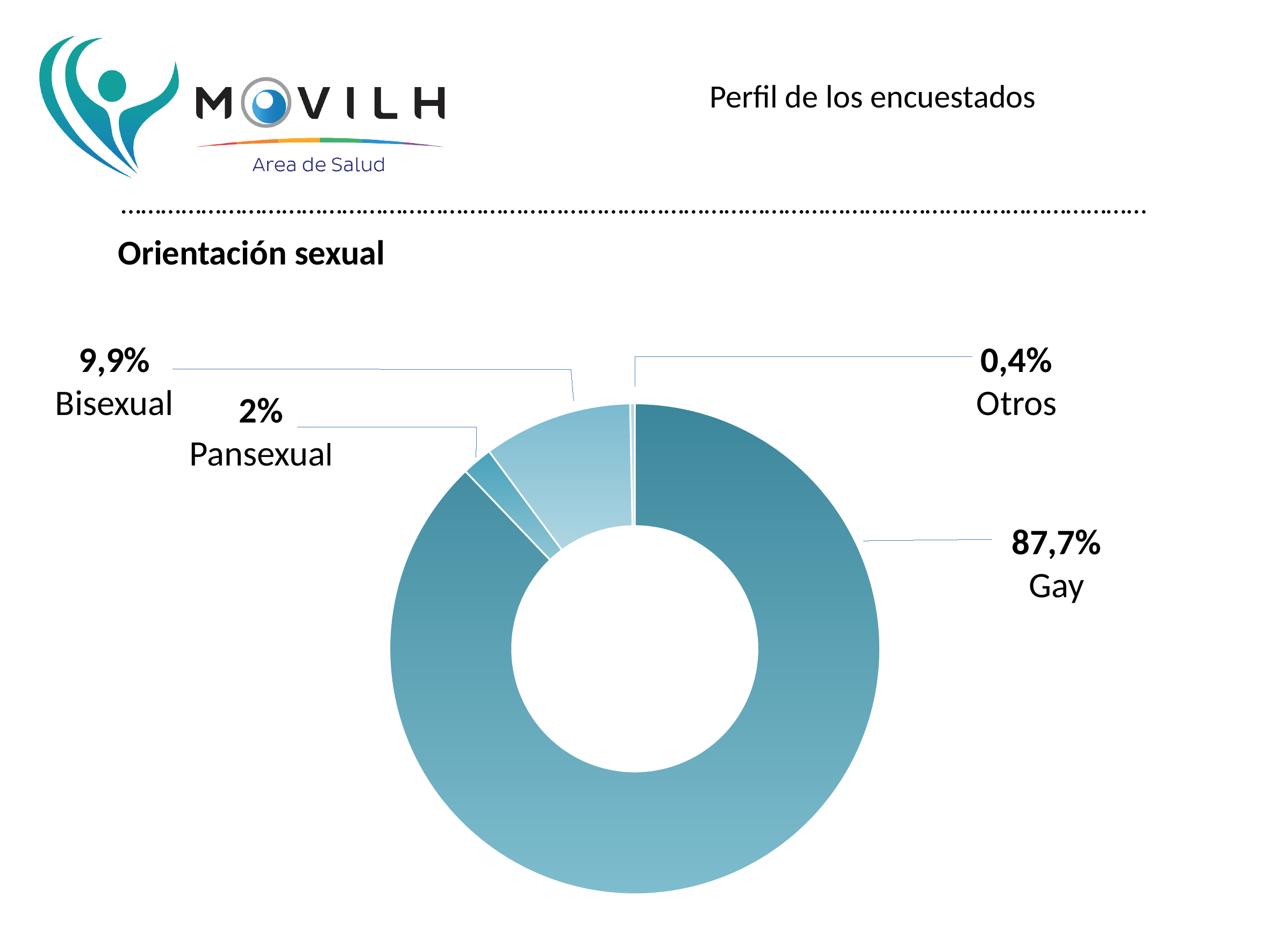
What percentage of respondents fall under Otros? 0,4% Which is larger, the share for Bisexual or the share for Pansexual? Bisexual Which sexual orientation category has the largest share? Gay Which sexual orientation category has the smallest share? Otros What is the difference in percentage points between the Gay and Bisexual shares? 77,8 What percentage of respondents identified as Gay? 87,7% What percentage of respondents identified as Bisexual? 9,9% What percentage of respondents identified as Pansexual? 2% What kind of chart is shown on the slide? Doughnut (pie) chart How many categories are shown in the chart? 4 What is the difference in percentage points between the Pansexual and Otros shares? 1,6 What is the title of the chart? Orientación sexual